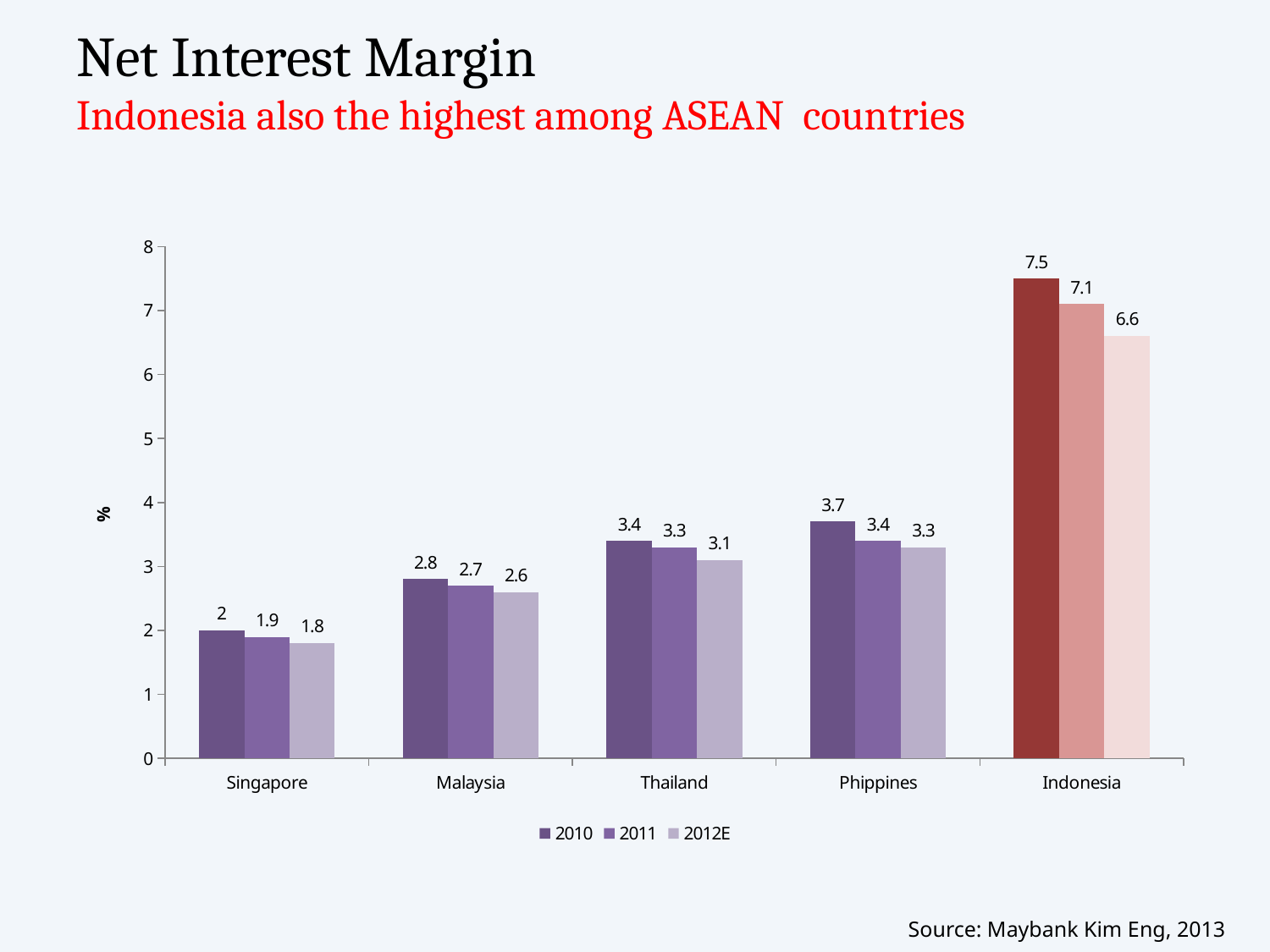
Is the 2011 value for Indonesia greater or less than 7? greater What kind of chart is shown on the slide? bar chart Which is larger, the 2010 value for Phippines or the 2010 value for Thailand? Phippines How many series does the legend list? 3 How many countries are shown on the x axis? 5 For Singapore, do the values rise or fall from 2010 to 2012E? fall What is the 2012E value for Malaysia? 2.6 What is the net interest margin for Indonesia in 2010? 7.5 What is the 2011 value for Thailand? 3.3 What is the difference between Indonesia's 2010 value and its 2012E value? 0.9 Which country has the lowest net interest margin in 2010? Singapore Which country has the highest net interest margin in 2012E? Indonesia